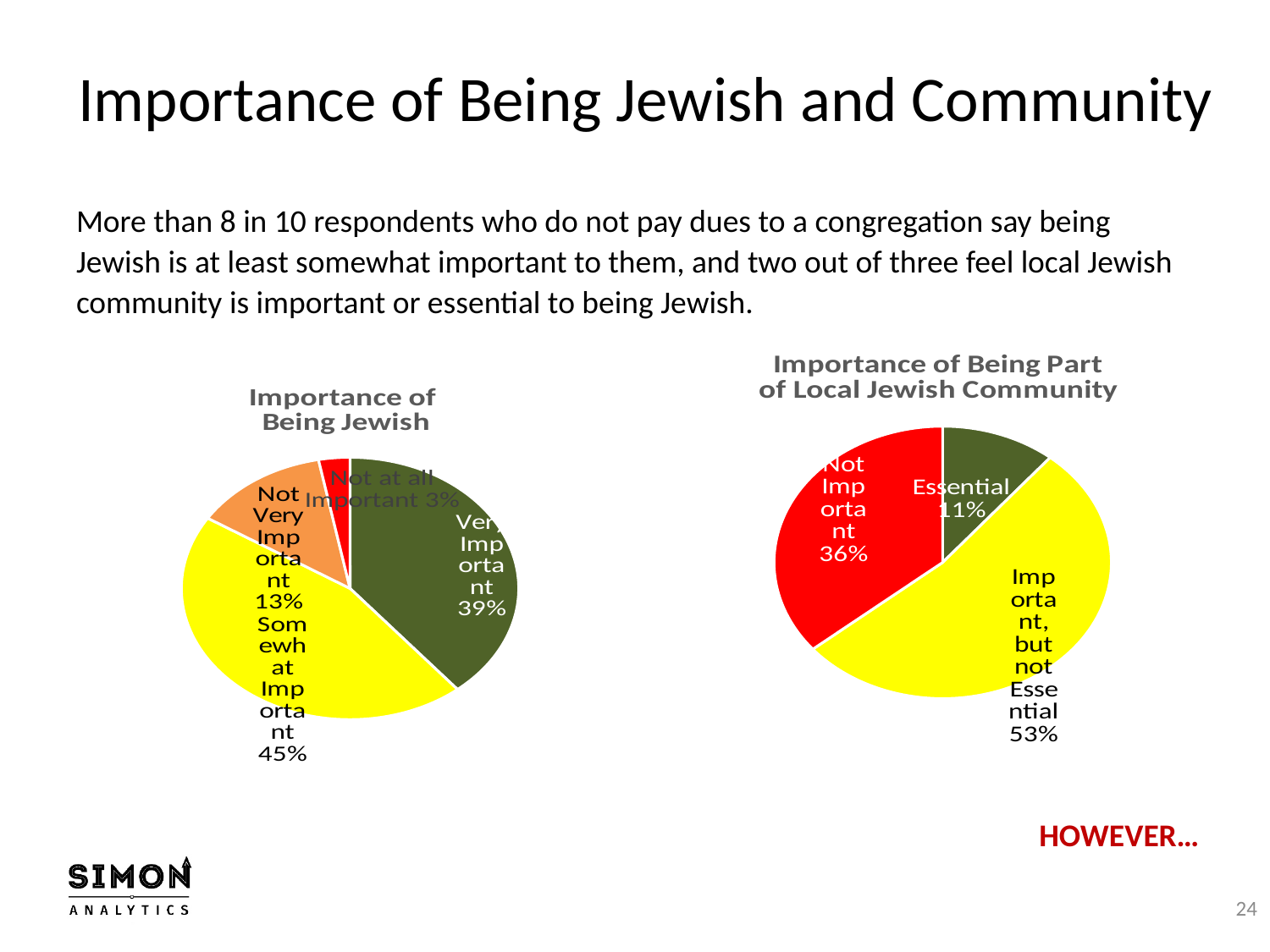
In the 'Importance of Being Jewish' chart, what share of respondents say being Jewish is Very Important? 39% In the 'Importance of Being Part of Local Jewish Community' chart, which category has the largest slice? Important, but not Essential In the 'Importance of Being Part of Local Jewish Community' chart, what is the difference between the Not Important and Essential shares? 25% What type of chart is used for 'Importance of Being Jewish'? Pie chart In the 'Importance of Being Jewish' chart, which category has the largest slice? Somewhat Important In the 'Importance of Being Jewish' chart, which category has the smallest slice? Not at all Important In the 'Importance of Being Part of Local Jewish Community' chart, what share of respondents say it is Essential? 11% In the 'Importance of Being Part of Local Jewish Community' chart, what share of respondents say it is Not Important? 36% In the 'Importance of Being Part of Local Jewish Community' chart, how many categories are shown? 3 In the 'Importance of Being Jewish' chart, how many categories are shown? 4 In the 'Importance of Being Jewish' chart, what share of respondents say being Jewish is Not Very Important? 13% In the 'Importance of Being Jewish' chart, what share of respondents say being Jewish is Somewhat Important? 45%